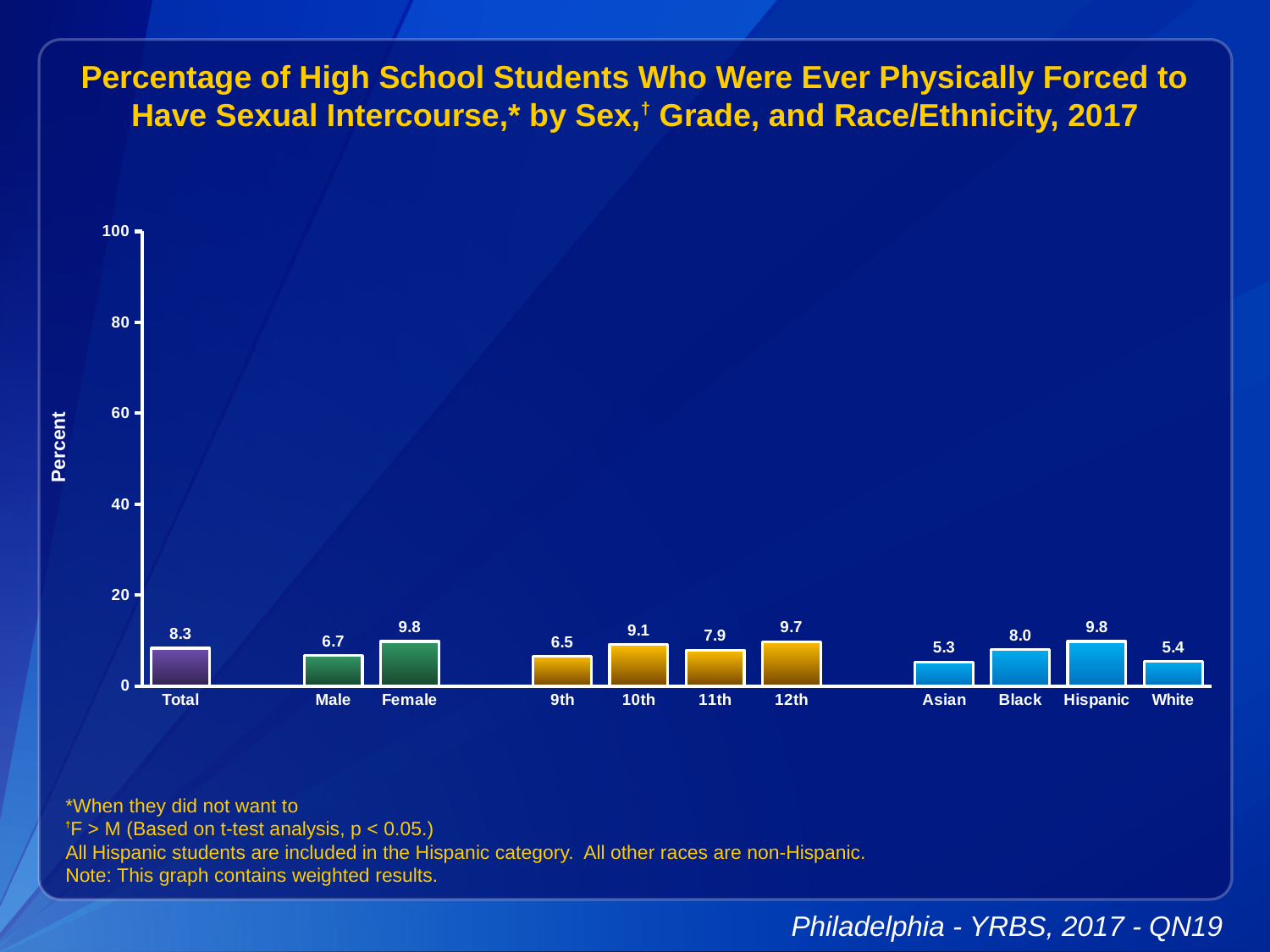
What is the value for Total? 8.3 Is the value for Total greater or less than 20? less What is the label on the vertical axis? Percent Among the grade categories (9th, 10th, 11th, 12th), which has the highest value? 12th What is the difference between the Female and Male values? 3.1 What kind of chart is shown on the slide? bar chart What is the value for Female? 9.8 Among the grade categories (9th, 10th, 11th, 12th), which has the lowest value? 9th How many bars are plotted on the chart? 11 What is the value for Asian students? 5.3 Which is larger, the value for Black or the value for White? Black What is the value for 11th grade? 7.9